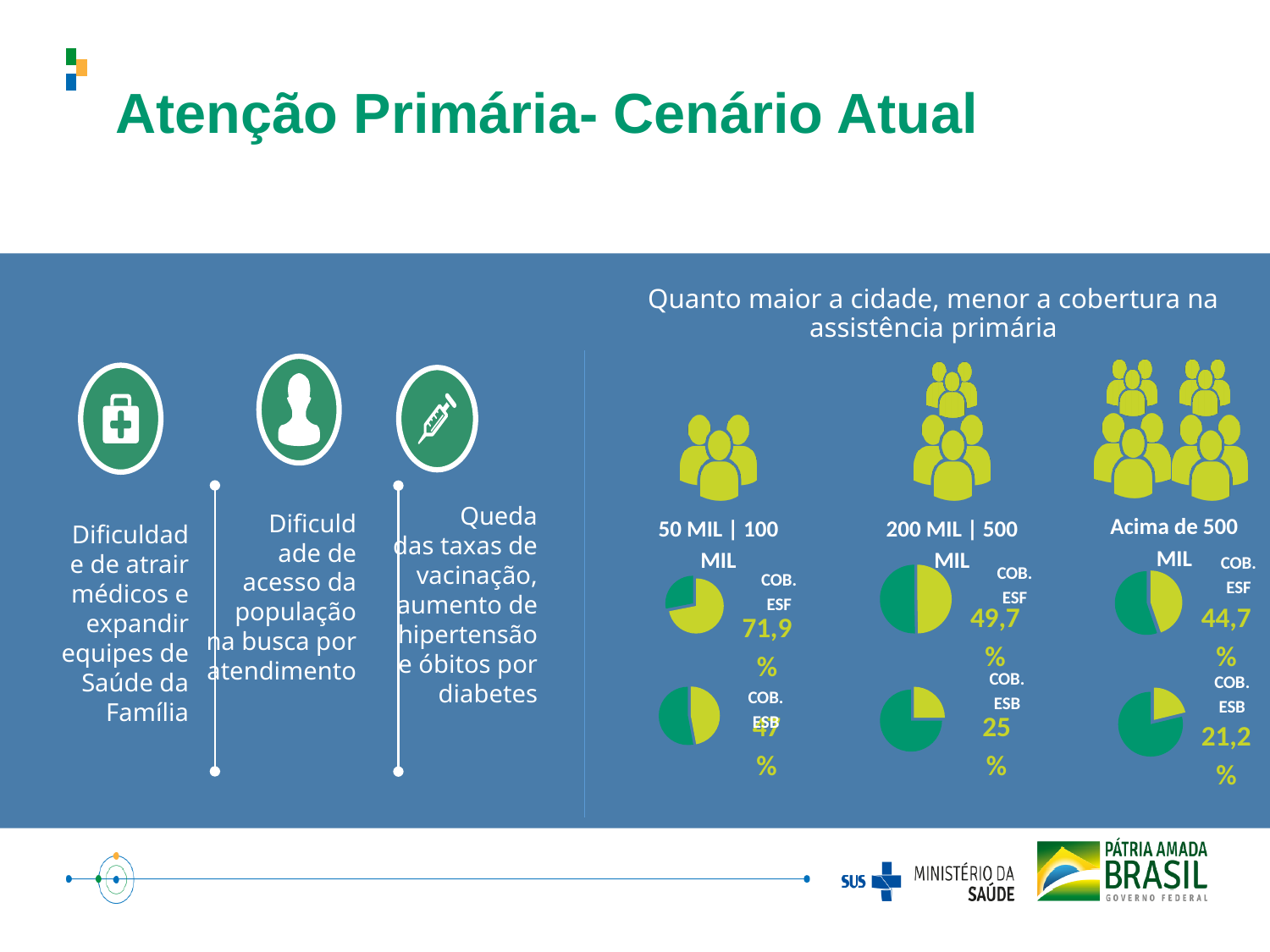
What is the COB. ESF value shown for cities of 200 MIL | 500 MIL? 49,7% What is the difference between the COB. ESB values for 200 MIL | 500 MIL and Acima de 500 MIL? 3,8% Which city-size group has the highest COB. ESF coverage? 50 MIL | 100 MIL How does COB. ESF coverage change as city size increases from 50 MIL | 100 MIL to Acima de 500 MIL? It decreases What is the COB. ESB value shown for cities Acima de 500 MIL? 21,2% Which city-size group has the lowest COB. ESB coverage? Acima de 500 MIL Which is larger: the COB. ESF value for 200 MIL | 500 MIL or for Acima de 500 MIL? 200 MIL | 500 MIL What kind of charts are used to show the COB. ESF and COB. ESB coverage values? Pie charts What is the COB. ESF value shown for cities of 50 MIL | 100 MIL? 71,9% What is the COB. ESB value shown for cities of 200 MIL | 500 MIL? 25% What is the difference between the COB. ESF values for 50 MIL | 100 MIL and 200 MIL | 500 MIL? 22,2% What is the COB. ESF value shown for cities Acima de 500 MIL? 44,7%